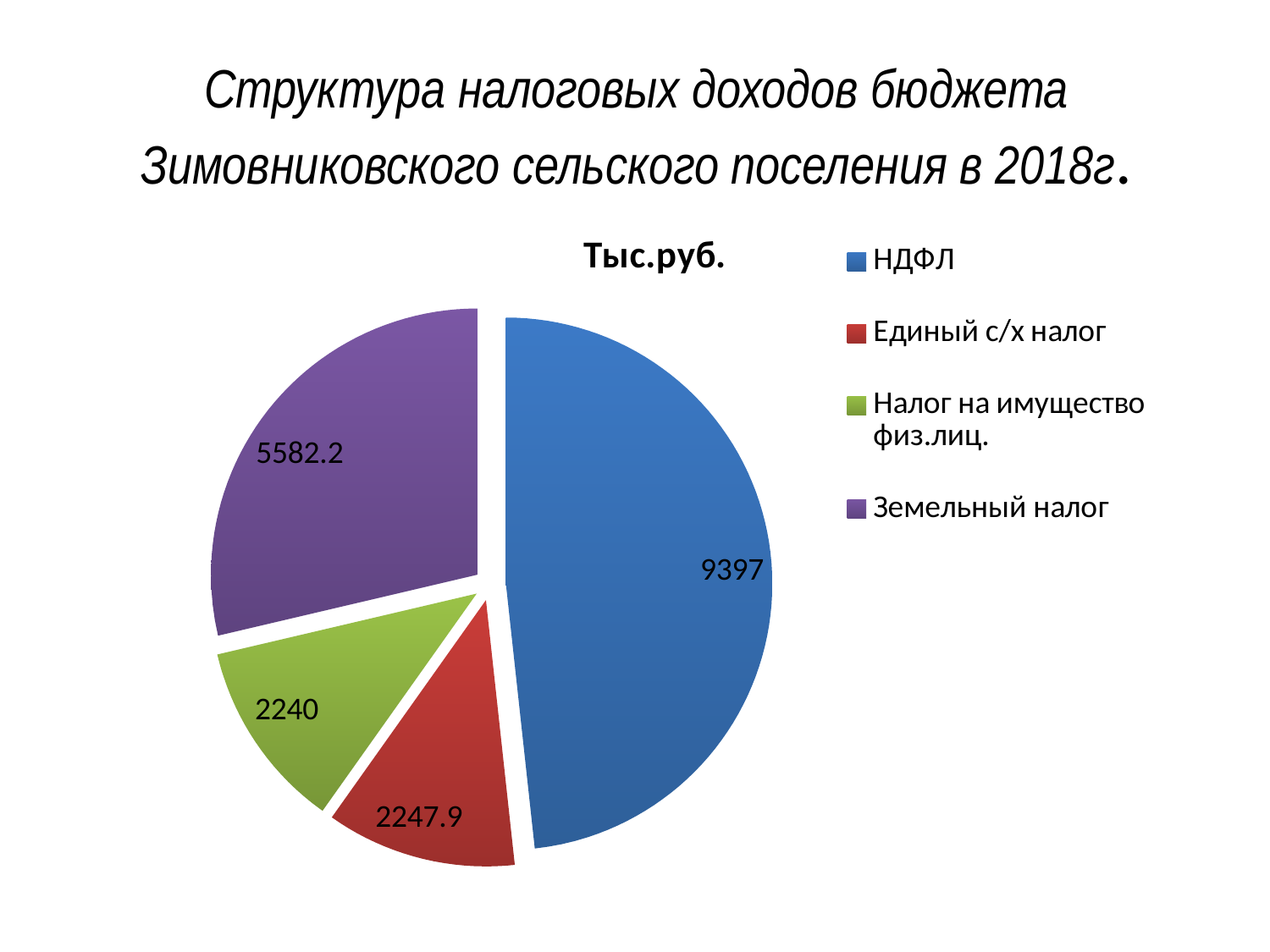
What colour is the slice for Земельный налог? Purple What is the value for НДФЛ? 9397 What is the value for Налог на имущество физ.лиц.? 2240 Which is larger, the value for Земельный налог or the value for Единый с/х налог? Земельный налог Which category has the highest value? НДФЛ Which category has the lowest value? Налог на имущество физ.лиц. What is the value for Земельный налог? 5582.2 How many slices does the pie chart have? 4 What is the title shown above the pie chart? Тыс.руб. What is the value for Единый с/х налог? 2247.9 What is the difference between the values for НДФЛ and Земельный налог? 3814.8 What kind of chart is shown on the slide? Pie chart